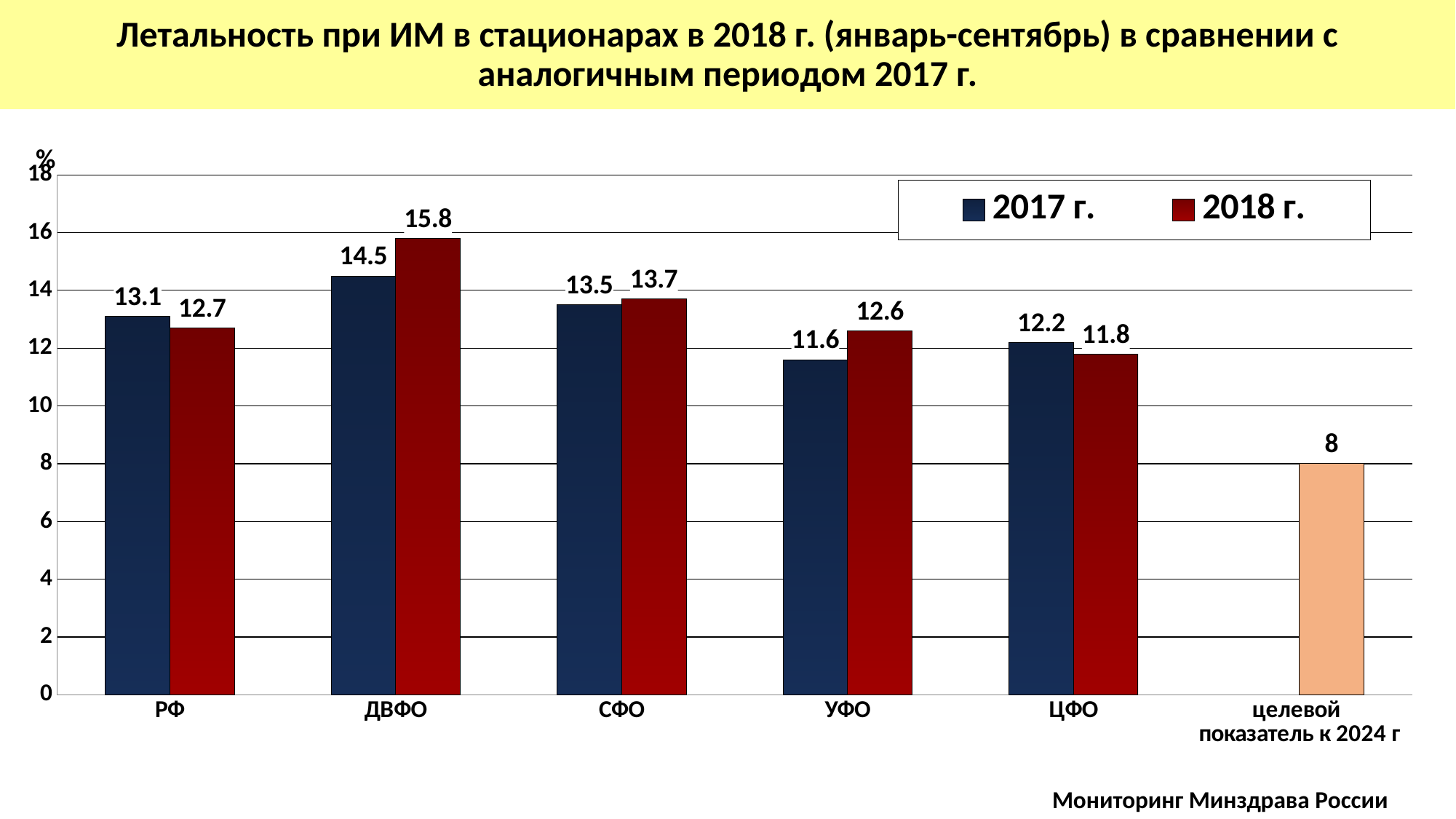
What is the difference between the 2017 г. and 2018 г. values for ЦФО? 0.4 What kind of chart is shown on the slide? bar chart What is the value for РФ in the 2017 г. series? 13.1 How many series does the legend list? 2 What is the difference between the 2018 г. and 2017 г. values for ДВФО? 1.3 Which category has the lowest value in the 2017 г. series? УФО What is the value for ДВФО in the 2018 г. series? 15.8 What colour are the bars for the 2018 г. series? dark red Is the value for СФО in the 2017 г. series greater or less than 12? greater Which is larger for УФО: the 2017 г. value or the 2018 г. value? 2018 г. What is the value of the bar labelled 'целевой показатель к 2024 г'? 8 Which category has the highest value in the 2018 г. series? ДВФО